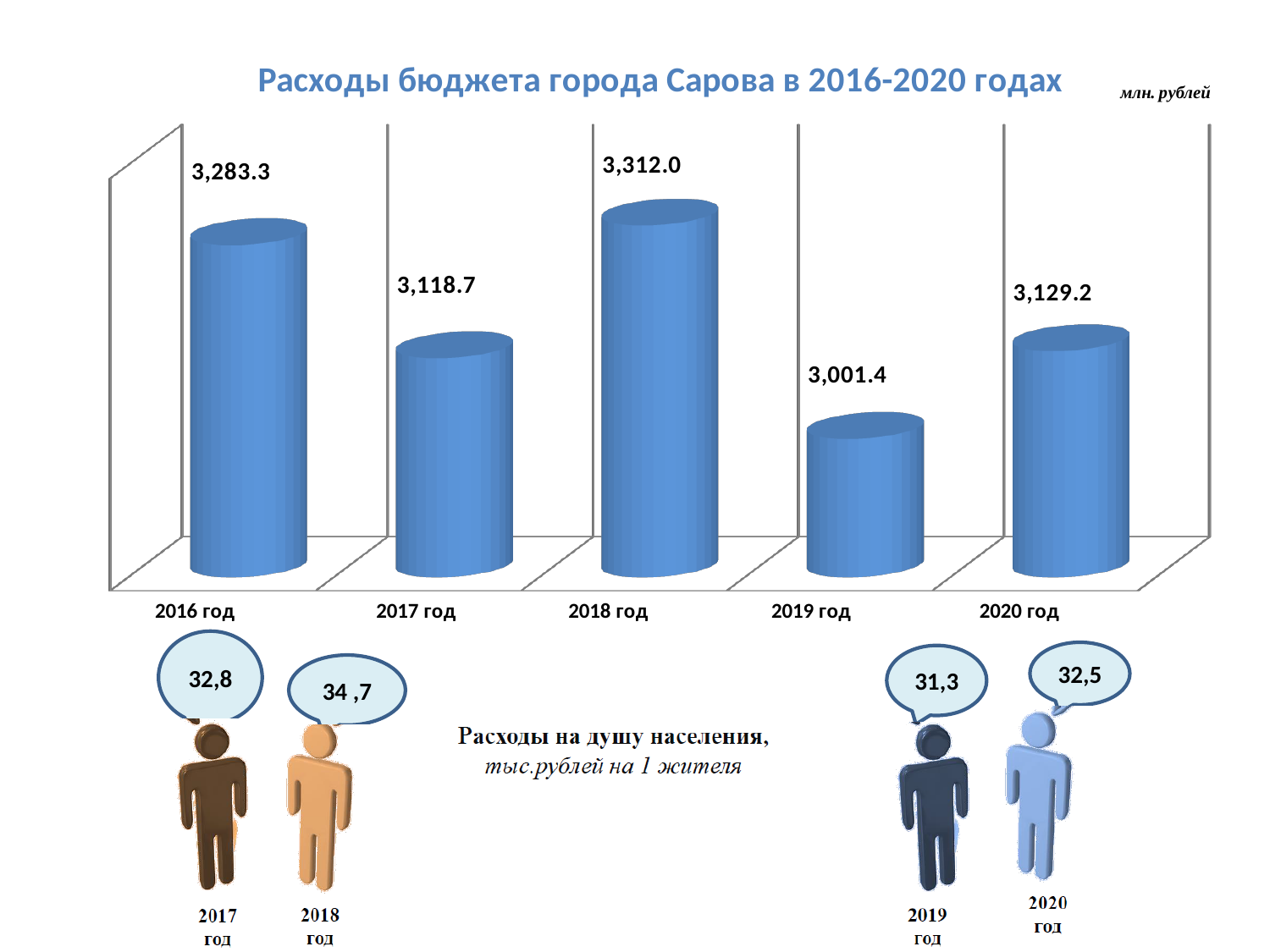
What is the difference between the values for 2016 год and 2017 год? 164.6 What is the value shown for 2016 год? 3,283.3 What unit of measurement is indicated for the chart values? млн. рублей What is the budget expenditure value shown for 2018 год? 3,312.0 What is the difference between the values for 2018 год and 2019 год? 310.6 Which is larger, the value for 2017 год or the value for 2020 год? 2020 год What is the value shown for 2019 год? 3,001.4 How many years are plotted in the chart? 5 What is the value shown for 2020 год? 3,129.2 Which year has the lowest budget expenditure? 2019 год Which year has the highest budget expenditure? 2018 год What type of chart is shown on the slide? bar chart